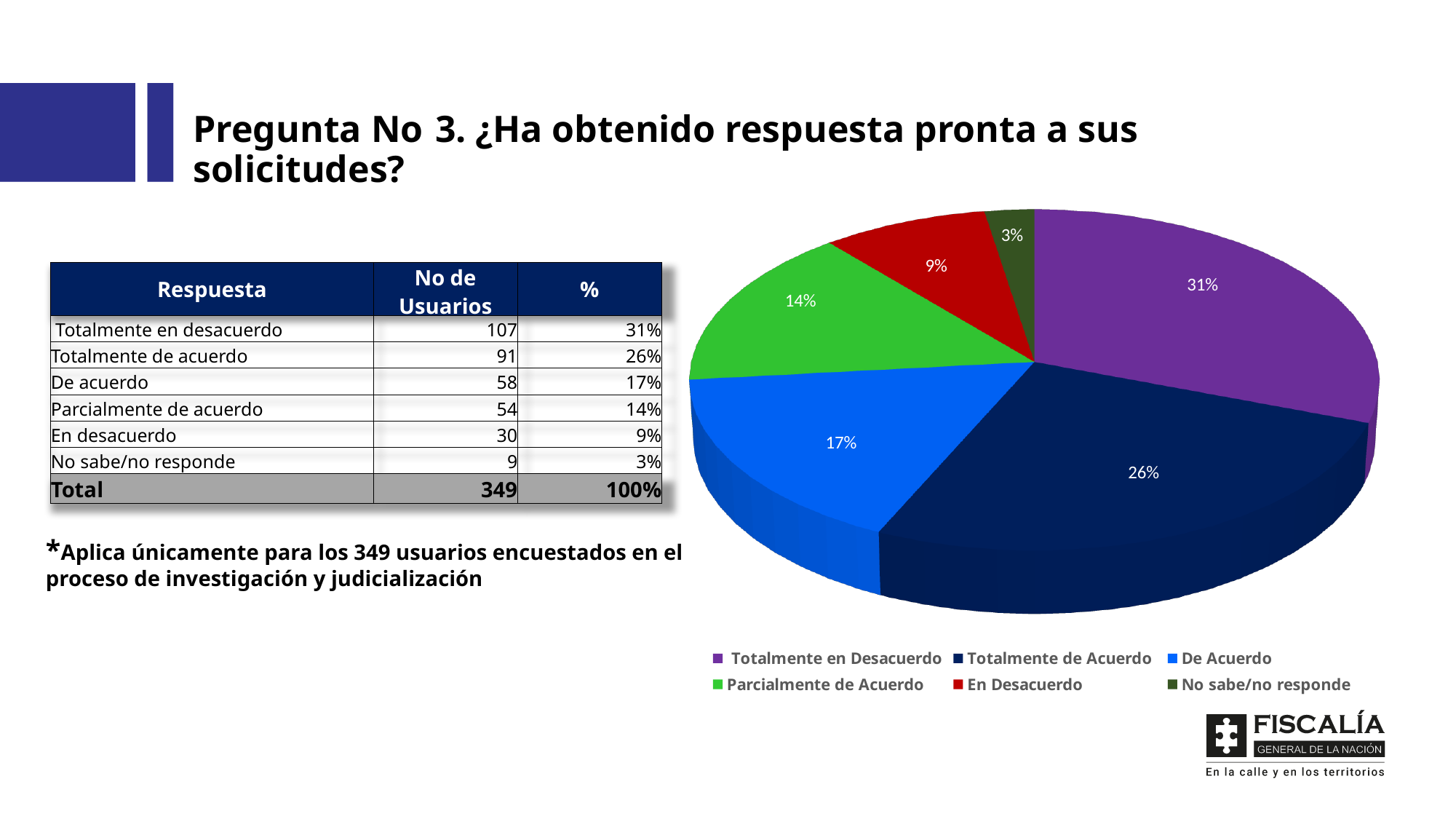
What share of the pie does 'De Acuerdo' represent? 17% What share of the pie does 'Totalmente en Desacuerdo' represent? 31% How many categories does the pie chart show? 6 What kind of chart is shown on the slide? Pie chart What colour is the slice for 'En Desacuerdo'? Red What share of the pie does 'Totalmente de Acuerdo' represent? 26% Which category has the smallest slice of the pie? No sabe/no responde Which category has the largest slice of the pie? Totalmente en Desacuerdo Which is larger, the slice for 'De Acuerdo' or the slice for 'Parcialmente de Acuerdo'? De Acuerdo What is the difference in percentage points between 'Totalmente en Desacuerdo' and 'Totalmente de Acuerdo'? 5